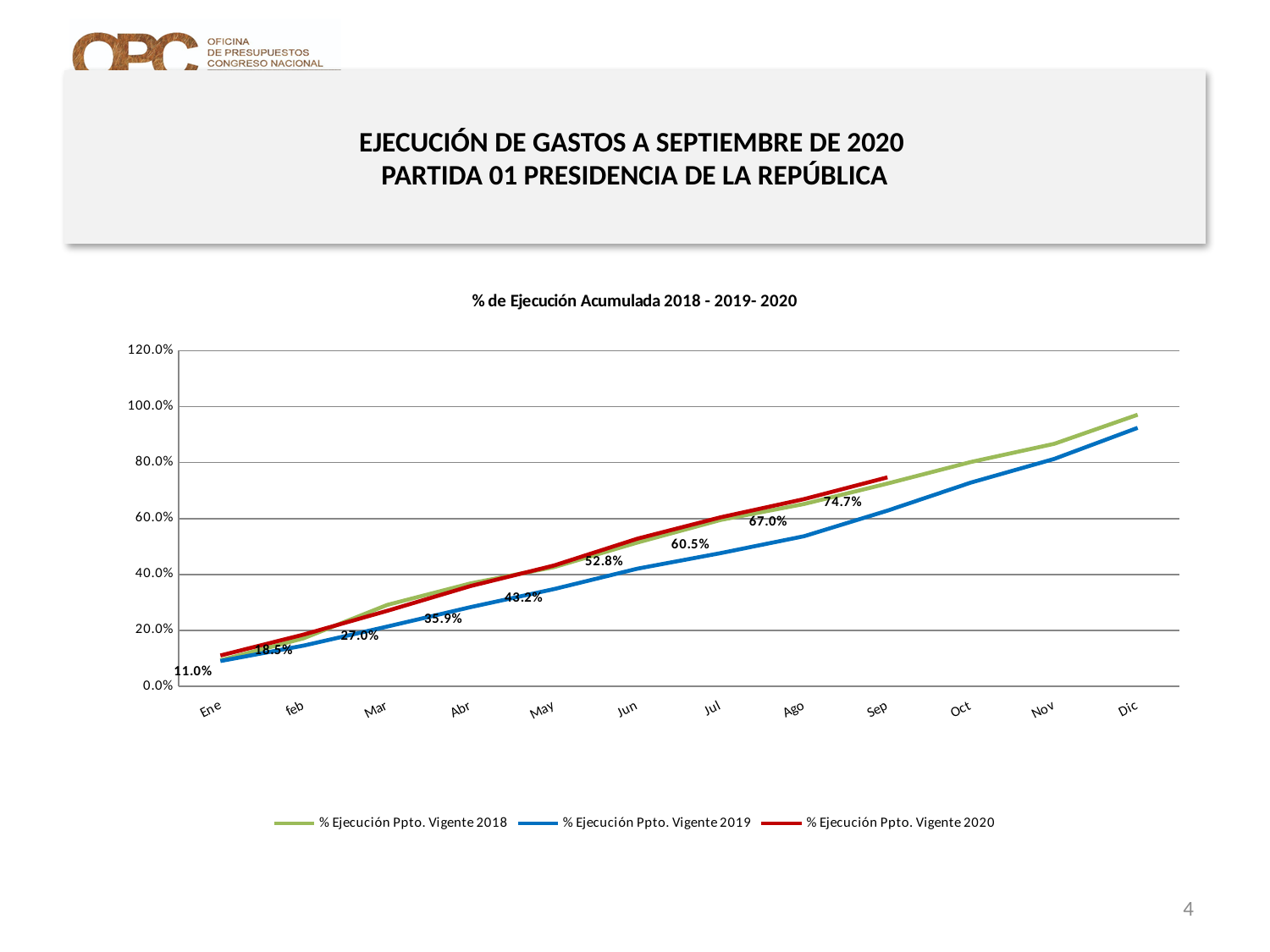
What is the value labelled for Ene on the % Ejecución Ppto. Vigente 2020 line? 11.0% What is the value labelled for Sep on the % Ejecución Ppto. Vigente 2020 line? 74.7% What is the difference between the Sep and Ago values labelled on the % Ejecución Ppto. Vigente 2020 line? 7.7% How many months are shown on the x axis? 12 Is the value for Dic on the % Ejecución Ppto. Vigente 2019 line greater or less than 80.0%? greater What is the value labelled for May on the % Ejecución Ppto. Vigente 2020 line? 43.2% What is the title of the chart? % de Ejecución Acumulada 2018 - 2019- 2020 How many series does the legend list? 3 What is the value labelled for Jul on the % Ejecución Ppto. Vigente 2020 line? 60.5% Do the values of the % Ejecución Ppto. Vigente 2020 line rise or fall from Ene to Sep? rise What kind of chart is shown on the slide? line chart In Dic, which line is higher: % Ejecución Ppto. Vigente 2018 or % Ejecución Ppto. Vigente 2019? % Ejecución Ppto. Vigente 2018